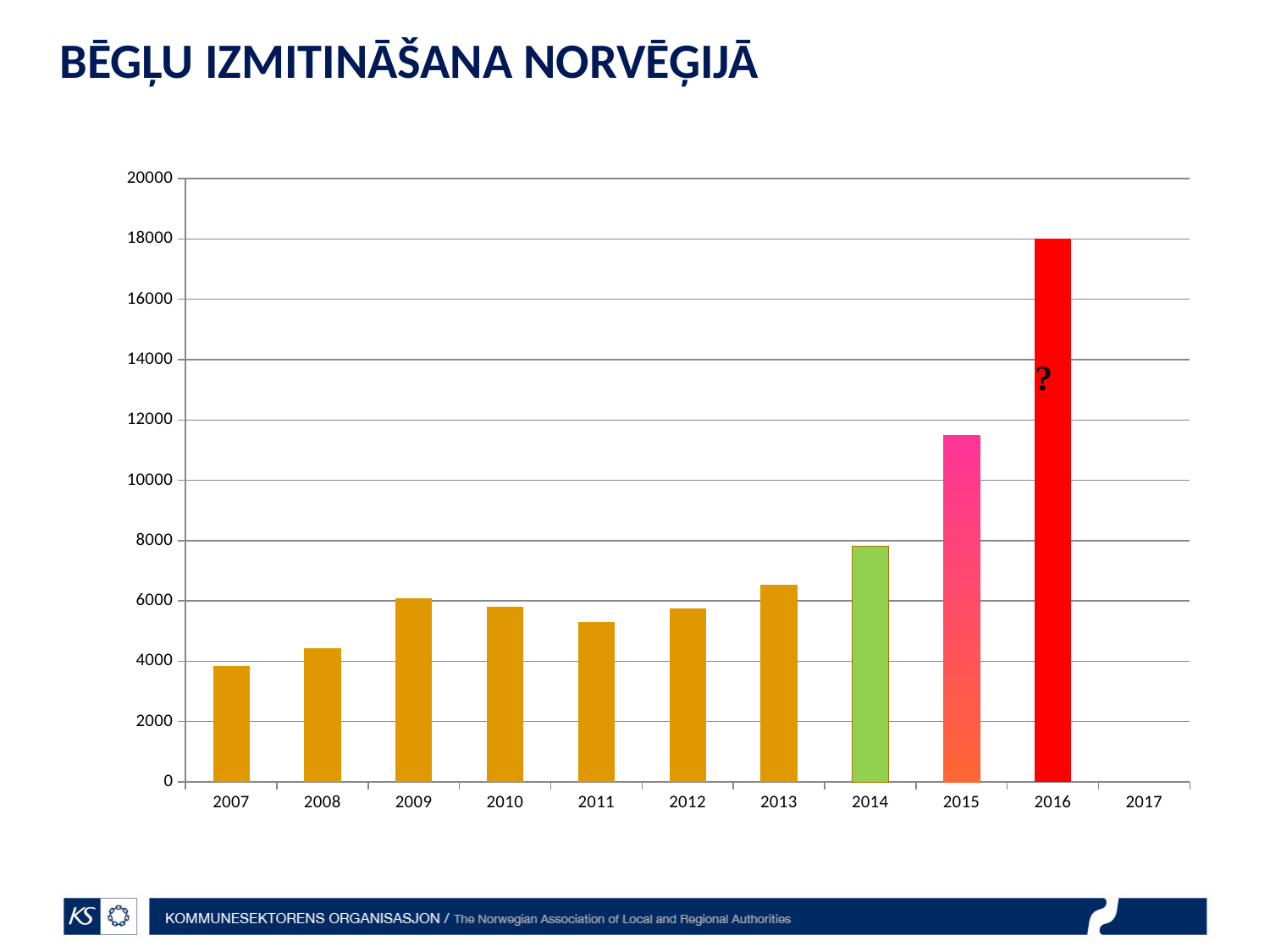
Which is larger, the value for 2011 or the value for 2013? 2013 What is the value for 2016? 18000 What is the title of the chart slide? BĒGĻU IZMITINĀŠANA NORVĒĢIJĀ What kind of chart is shown on the slide? bar chart Is the value for 2015 greater or less than 10000? greater Do the values rise or fall from 2013 to 2016? rise How many years are labelled on the x axis? 11 Is the value for 2007 greater or less than 4000? less Is the value for 2014 greater or less than 8000? less Which year has the highest bar? 2016 Which year with a bar has the lowest value? 2007